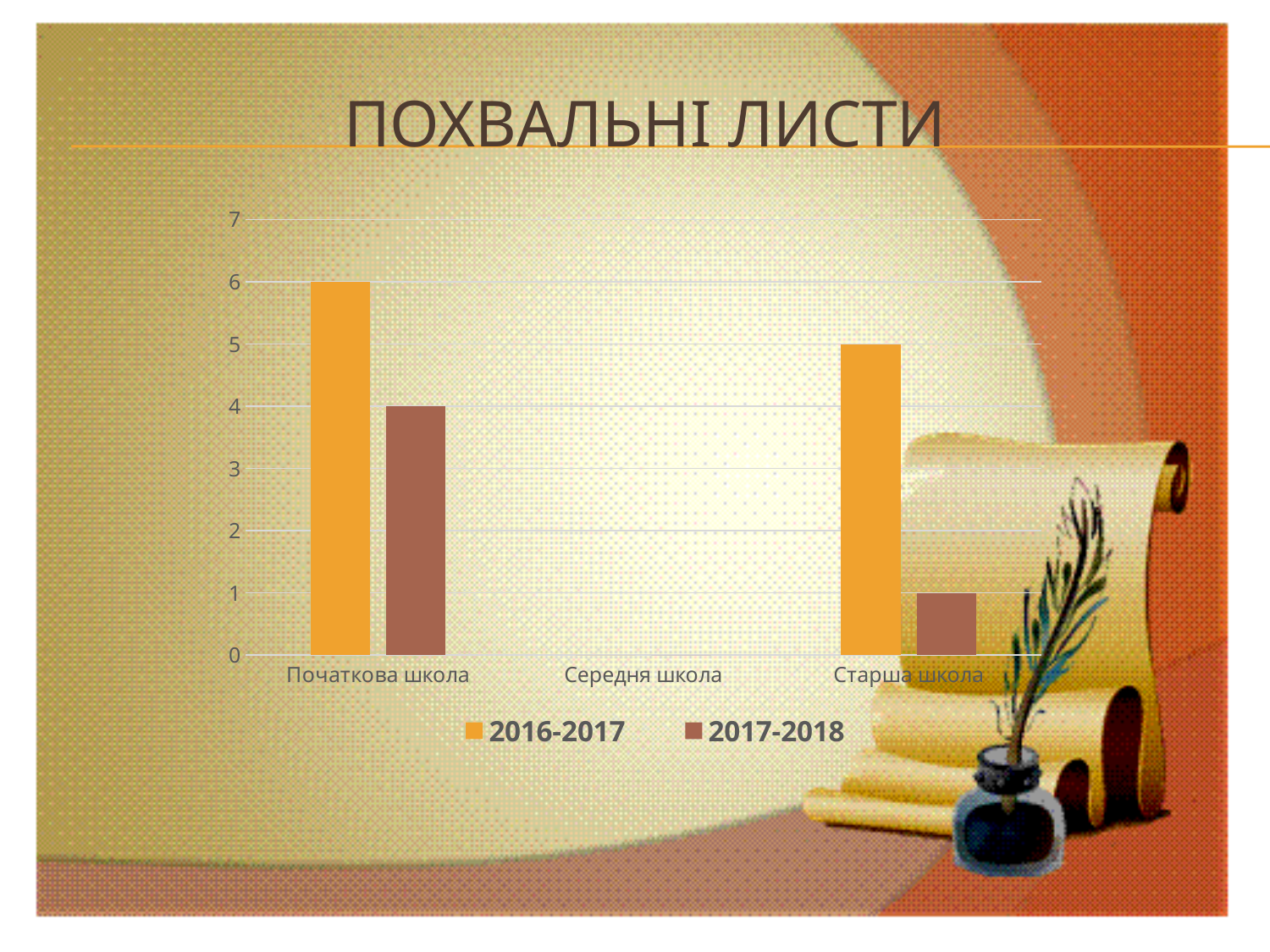
What is the value for Старша школа in the 2017-2018 series? 1 Which category has the highest value in the 2016-2017 series? Початкова школа What is the value for Початкова школа in the 2017-2018 series? 4 What is the difference between the 2016-2017 and 2017-2018 values for Старша школа? 4 Which series is shown in orange in the legend? 2016-2017 How many categories are shown on the x axis? 3 How many series does the legend list? 2 What type of chart is shown on the slide? bar chart What is the title of the chart? ПОХВАЛЬНІ ЛИСТИ Which is larger for Початкова школа: the 2016-2017 value or the 2017-2018 value? 2016-2017 What is the value for Старша школа in the 2016-2017 series? 5 What is the value for Початкова школа in the 2016-2017 series? 6